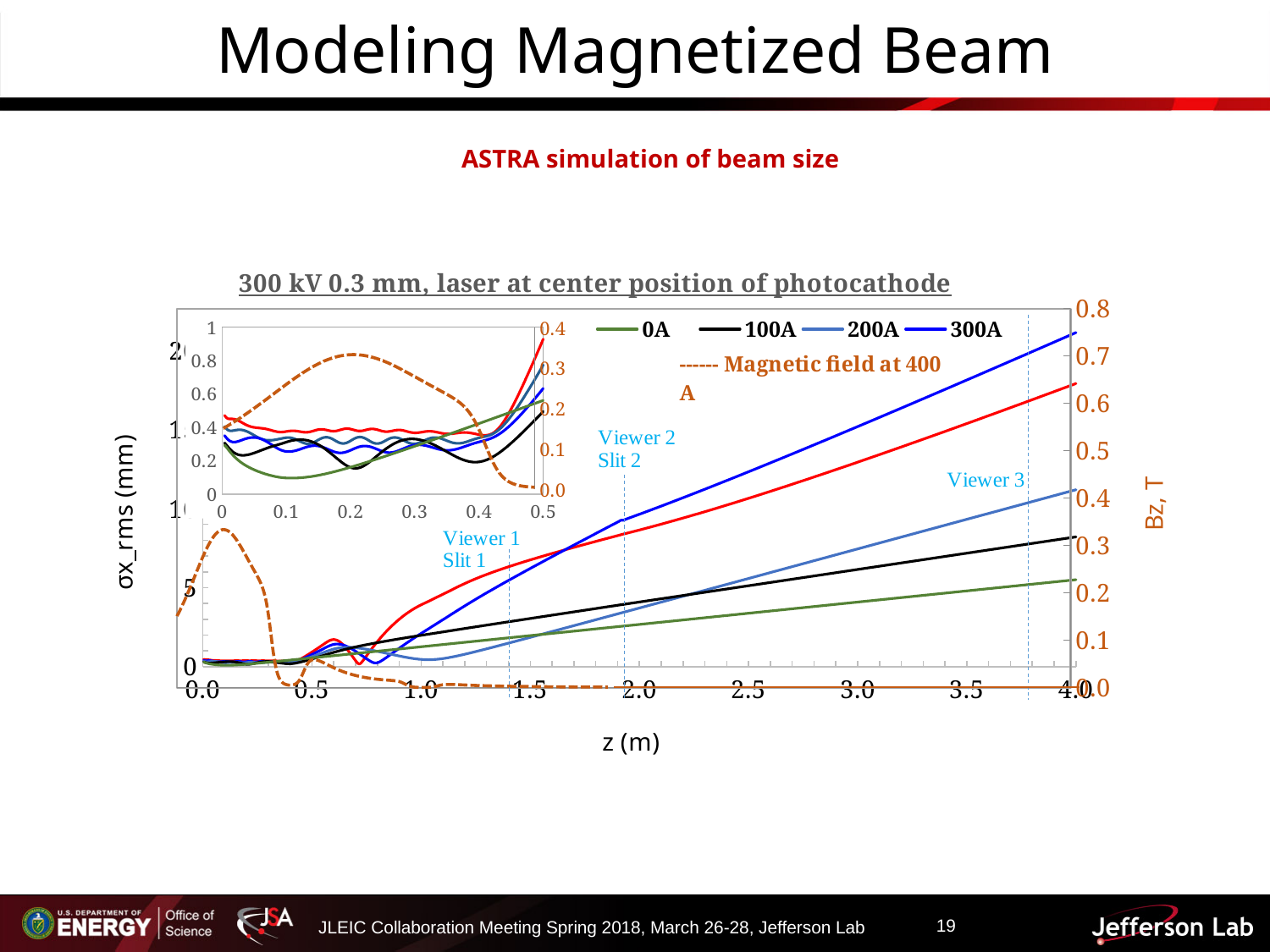
Is the peak of the magnetic field curve (right axis) greater or less than 0.4 T? less What is the label of the x axis of the chart? z (m) Does the 0A series rise or fall as z increases from 1.0 m to 4.0 m? rise Is the value of the 100A series at z = 4.0 m greater or less than 10 mm? less At z = 4.0 m, which of the four current series (0A, 100A, 200A, 300A) has the smallest beam size? 0A What kind of chart is shown on the slide? line chart Is the value of the 300A series at z = 4.0 m greater or less than 15 mm? greater At z = 4.0 m, which series has the larger beam size, 300A or 100A? 300A How many entries does the chart legend list? 5 At z = 4.0 m, which of the four current series (0A, 100A, 200A, 300A) has the largest beam size? 300A At z = 4.0 m, which series has the larger beam size, 0A or 200A? 200A What is the title of the chart? 300 kV 0.3 mm, laser at center position of photocathode